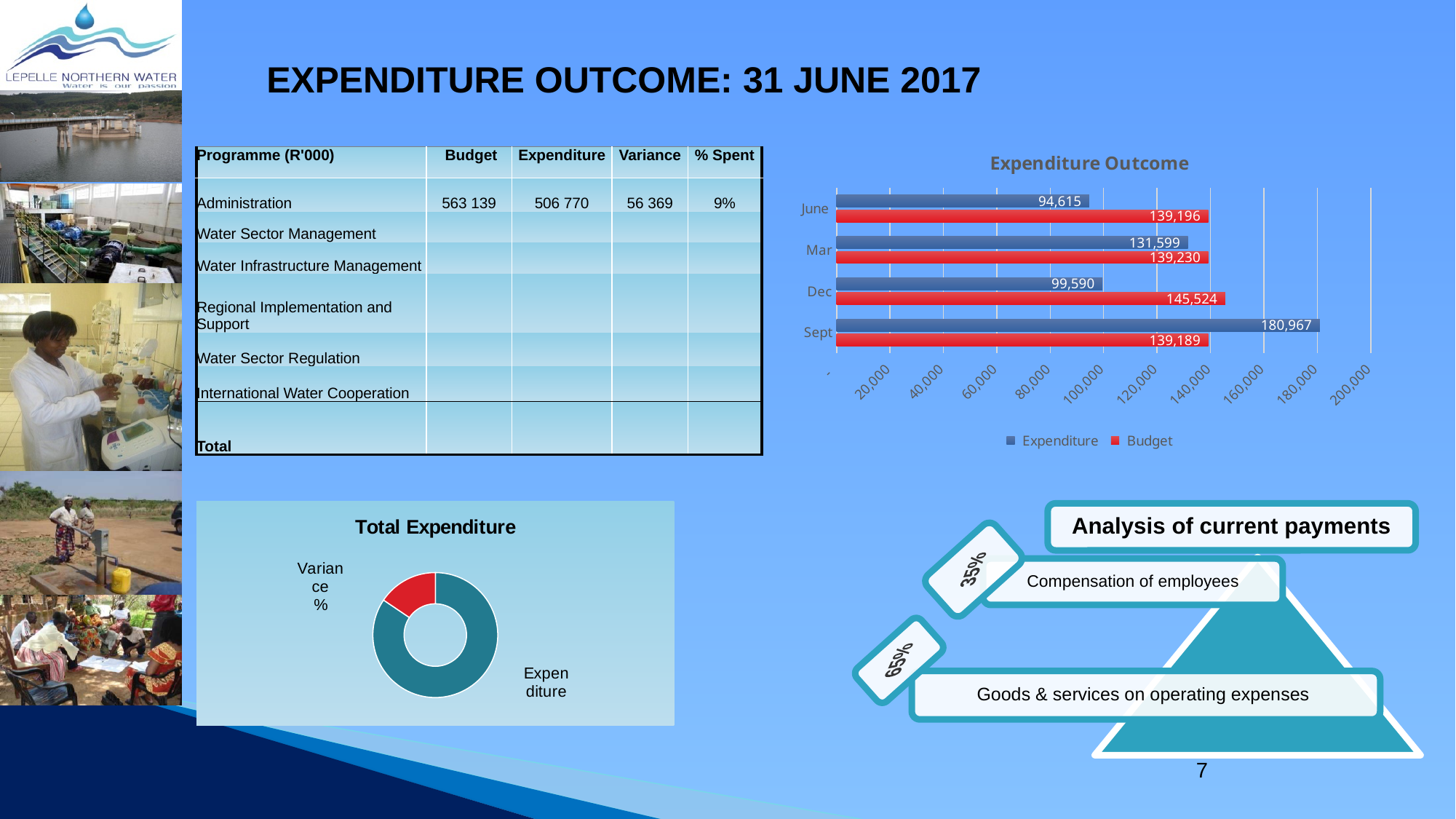
In the Expenditure Outcome chart, what is the difference between the Expenditure and Budget values for Sept? 41,778 In the Expenditure Outcome chart, for Dec, which is larger: Expenditure or Budget? Budget In the Expenditure Outcome chart, what is the Expenditure value for June? 94,615 In the Total Expenditure chart, which slice is larger: Expenditure or Variance %? Expenditure In the Expenditure Outcome chart, which month has the highest Expenditure value? Sept What kind of chart is the Expenditure Outcome chart? Bar chart In the Expenditure Outcome chart, which month has the highest Budget value? Dec In the Expenditure Outcome chart, which month has the lowest Expenditure value? June In the Expenditure Outcome chart, how many series does the legend list? 2 In the Expenditure Outcome chart, what is the Budget value for Dec? 145,524 In the Expenditure Outcome chart, what is the Expenditure value for Sept? 180,967 In the Expenditure Outcome chart, how many months are shown on the vertical axis? 4